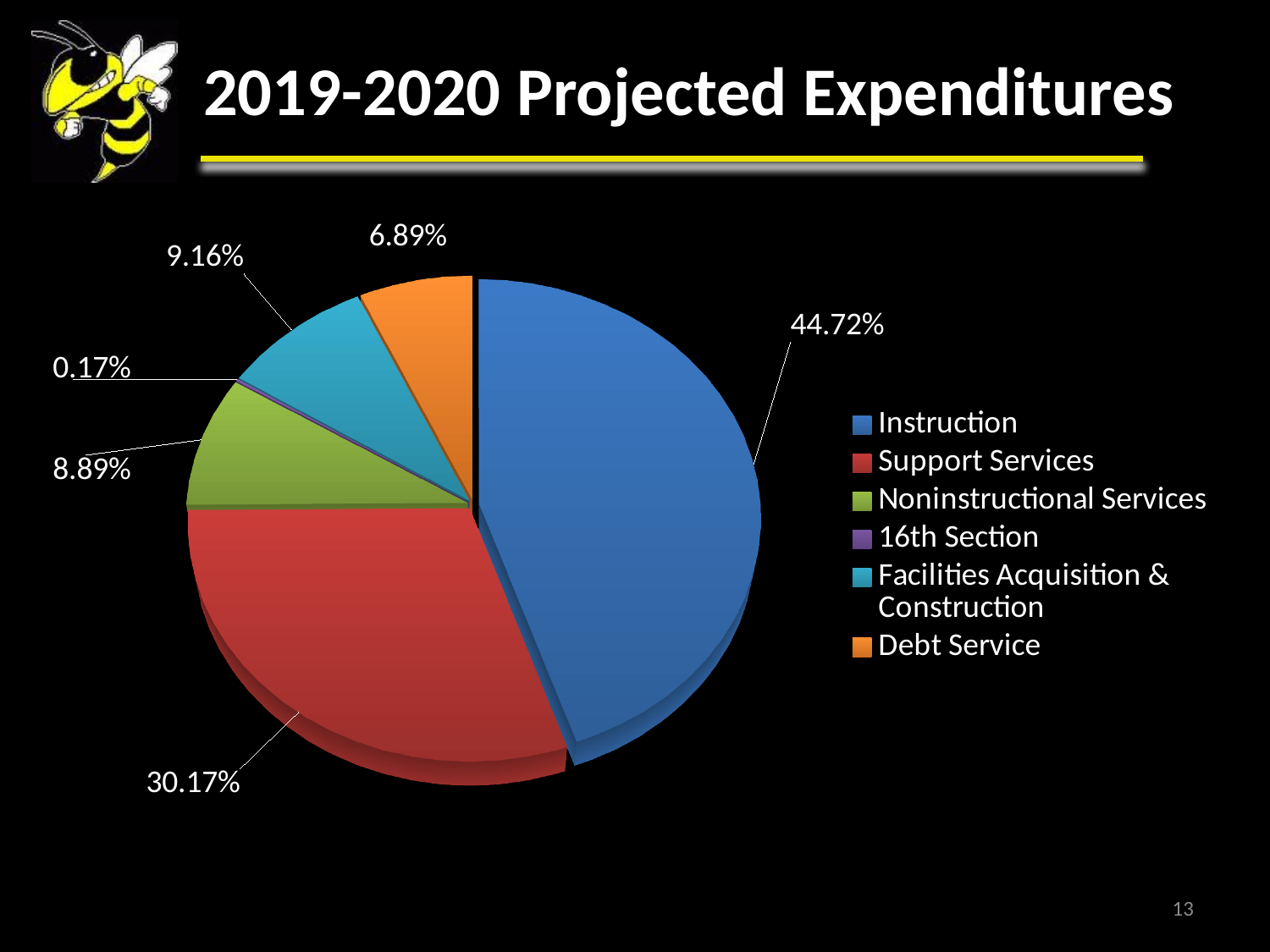
What share of projected expenditures goes to Instruction? 44.72% Which category has the largest share of projected expenditures? Instruction What kind of chart is shown on the slide? Pie chart What is the difference in percentage points between Instruction and Support Services? 14.55 Which category has the smallest share of projected expenditures? 16th Section What share of projected expenditures goes to 16th Section? 0.17% What share of projected expenditures goes to Noninstructional Services? 8.89% What share of projected expenditures goes to Support Services? 30.17% What share of projected expenditures goes to Debt Service? 6.89% What is the title of the slide containing the chart? 2019-2020 Projected Expenditures How many categories does the pie chart show? 6 What share of projected expenditures goes to Facilities Acquisition & Construction? 9.16%